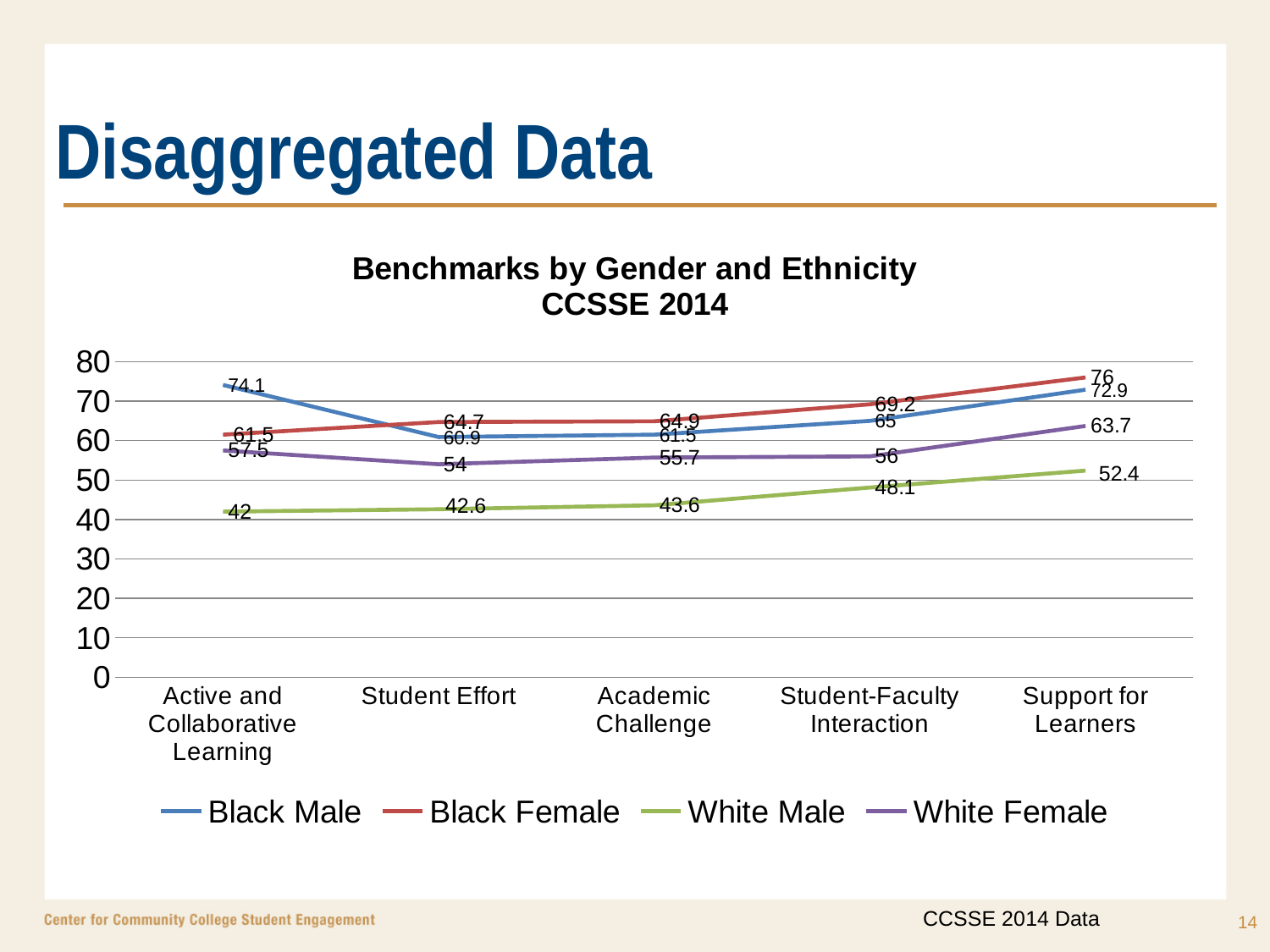
How many benchmark categories are shown on the x axis? 5 What is the White Female value for Student-Faculty Interaction? 56 How many series does the legend list? 4 What is the White Male value for Support for Learners? 52.4 For Active and Collaborative Learning, which is larger: the Black Male value or the Black Female value? Black Male Does the White Male line rise or fall from Active and Collaborative Learning to Support for Learners? Rise Which benchmark has the lowest Black Male value? Student Effort What kind of chart is shown on the slide? Line chart What is the difference between the Black Female and White Male values for Support for Learners? 23.6 Which benchmark has the highest White Male value? Support for Learners What is the Black Male value for Active and Collaborative Learning? 74.1 What is the Black Female value for Support for Learners? 76